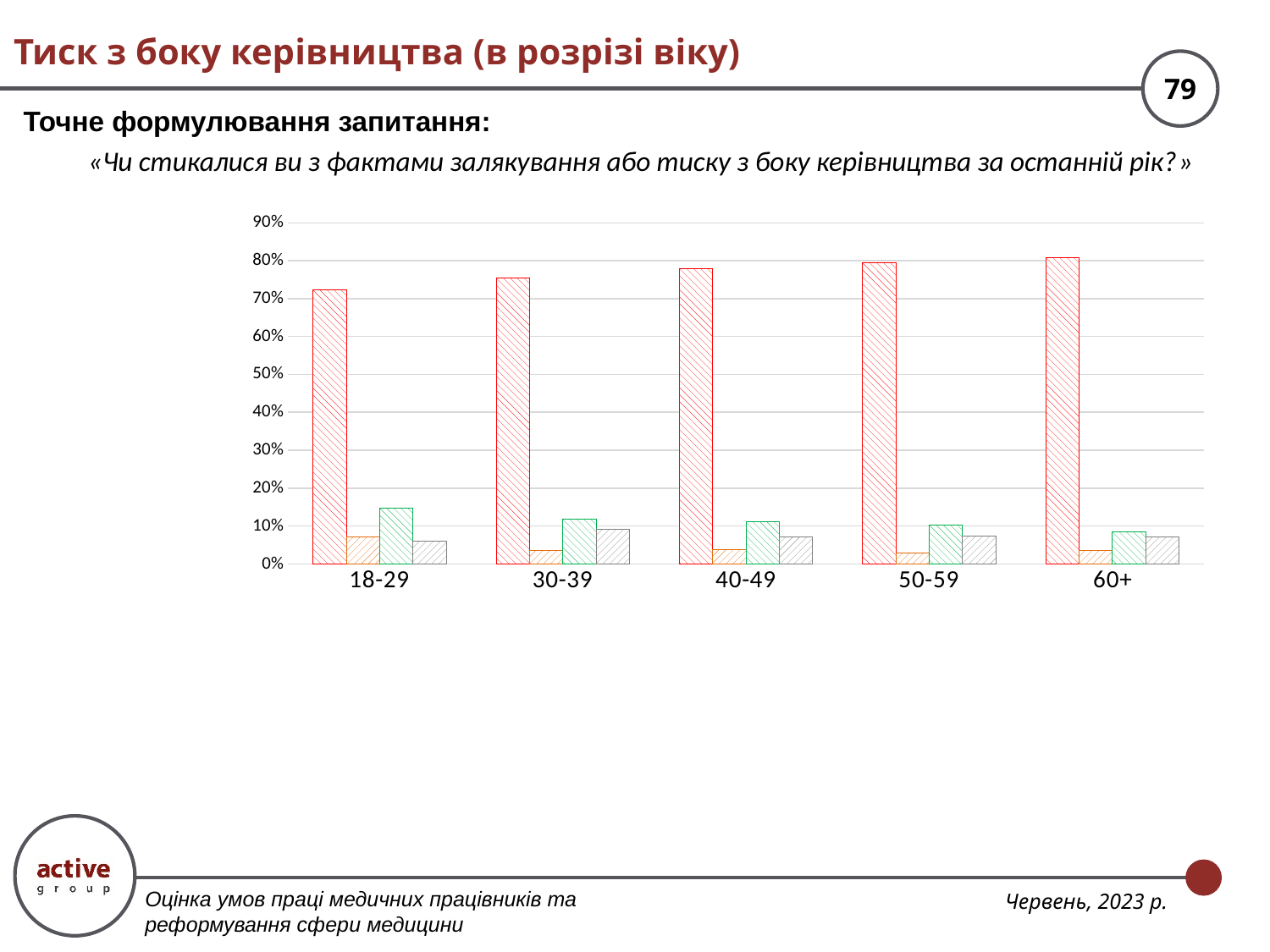
Is the value of the tallest (red) bar for 60+ greater or less than 90%? less Is the value of the green bar for 18-29 greater or less than 20%? less Do the values of the tallest (red) bars rise or fall as the age groups go from 18-29 to 60+? rise Is the value of the tallest (red) bar for 40-49 greater or less than 70%? greater What is the highest value shown on the vertical axis of the chart? 90% How many bars are plotted for each age group in the chart? 4 What kind of chart is shown on the slide? bar chart How many age groups are shown on the x axis of the chart? 5 Which age group has the lowest tallest (red) bar in the chart? 18-29 Which age group has the highest tallest (red) bar in the chart? 60+ Is the tallest (red) bar for 50-59 larger or smaller than the tallest (red) bar for 18-29? larger